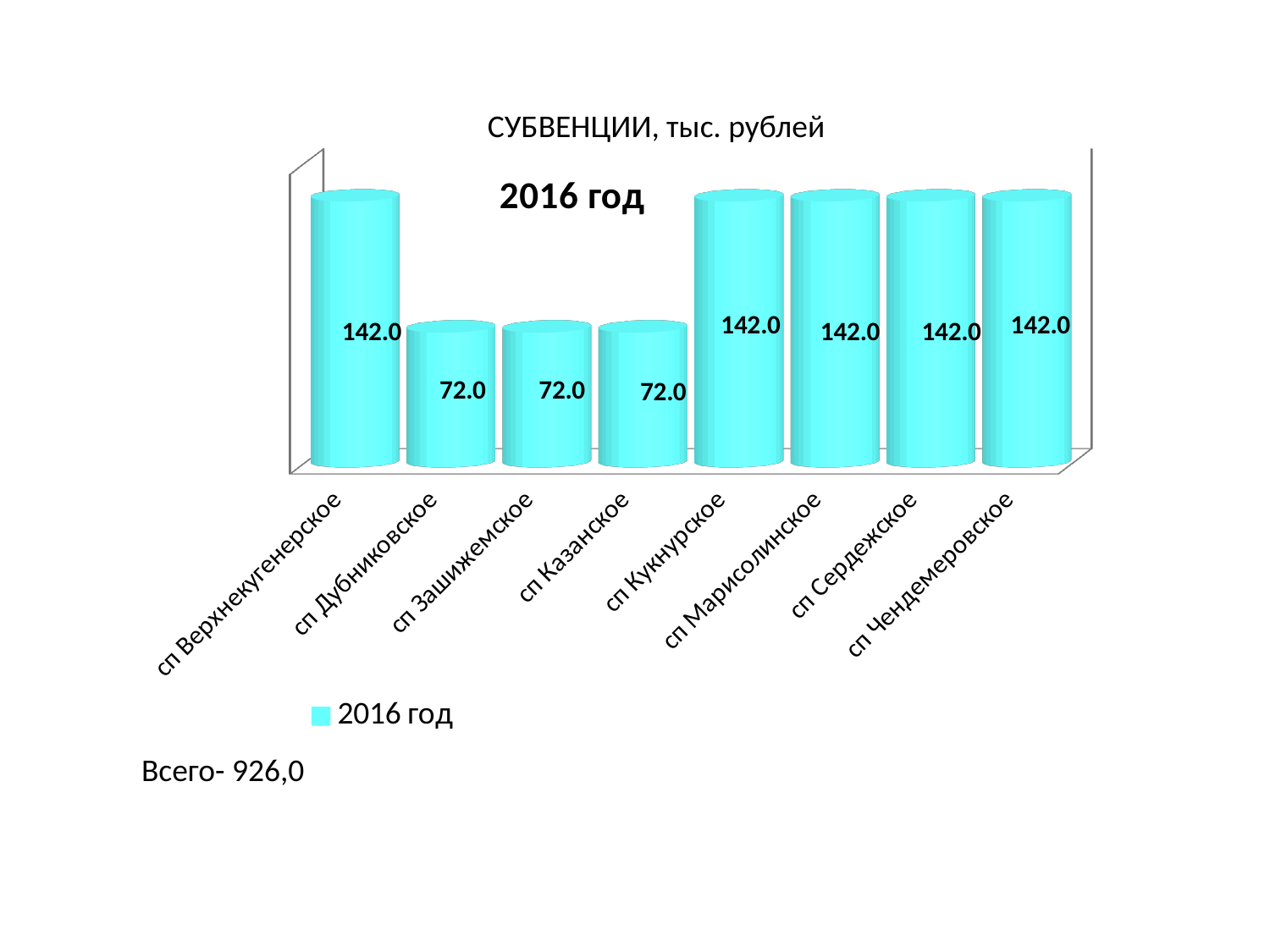
What is the value for сп Чендемеровское? 142.0 How many categories are shown on the x axis? 8 Which is larger, the value for сп Сердежское or the value for сп Казанское? сп Сердежское What is the value for сп Дубниковское? 72.0 What is the difference between the values for сп Кукнурское and сп Зашижемское? 70.0 What is the title of the chart? 2016 год What kind of chart is shown on the slide? bar chart What is the value for сп Марисолинское? 142.0 How many series does the legend list? 1 What is the value for сп Казанское? 72.0 What is the value for сп Верхнекугенерское? 142.0 What series name is listed in the legend? 2016 год